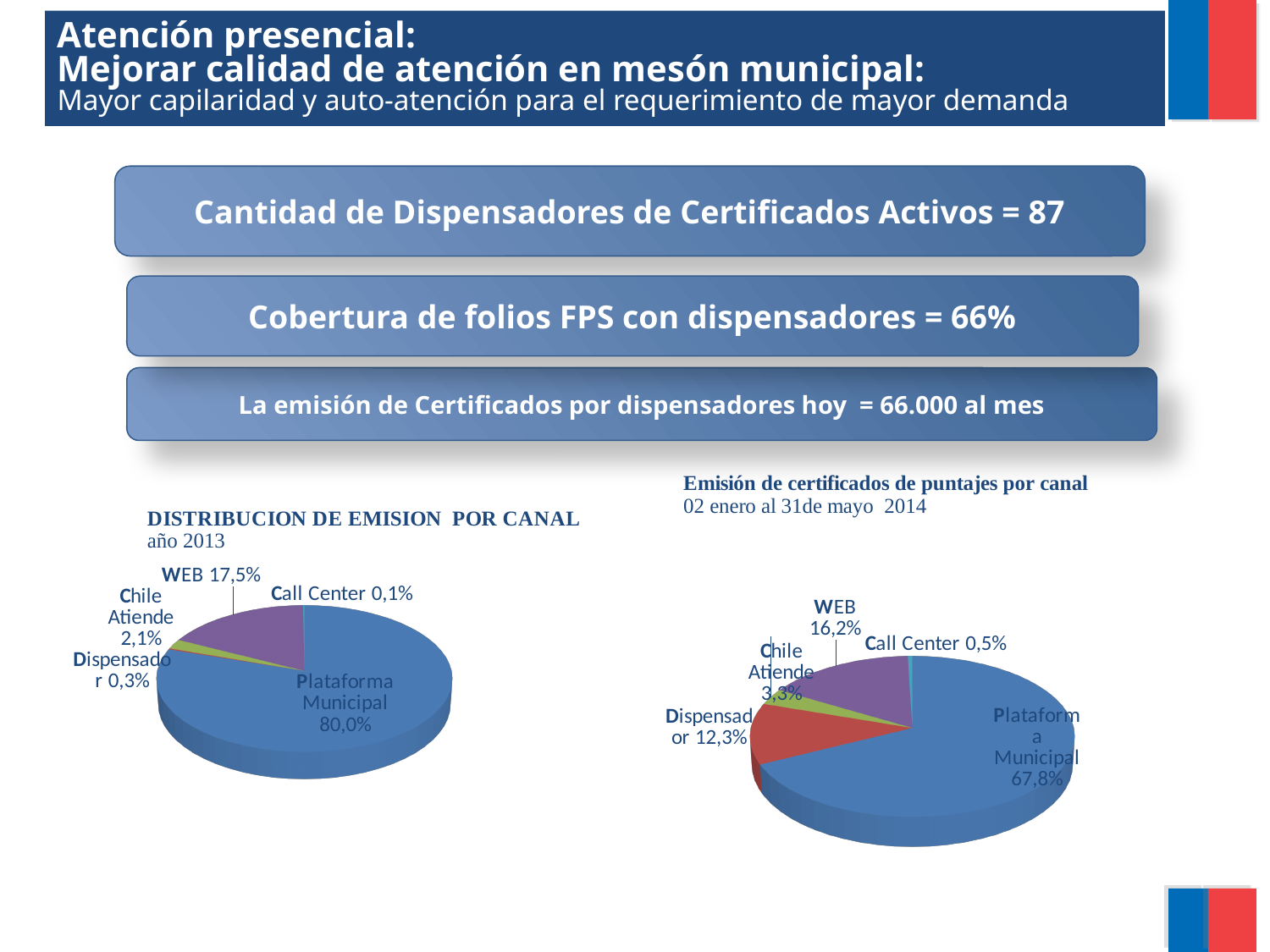
In the 2014 chart 'Emisión de certificados de puntajes por canal', what share does Dispensador have? 12,3% In the 2013 chart 'DISTRIBUCION DE EMISION POR CANAL', what share does Plataforma Municipal have? 80,0% In the 2013 chart 'DISTRIBUCION DE EMISION POR CANAL', what share does WEB have? 17,5% What type of chart is the 2013 chart 'DISTRIBUCION DE EMISION POR CANAL'? Pie chart In the 2014 chart 'Emisión de certificados de puntajes por canal', which is larger: WEB or Dispensador? WEB In the 2013 chart 'DISTRIBUCION DE EMISION POR CANAL', how many channels are shown? 5 In the 2014 chart 'Emisión de certificados de puntajes por canal', what share does Plataforma Municipal have? 67,8% In the 2014 chart 'Emisión de certificados de puntajes por canal', which channel has the largest share? Plataforma Municipal In the 2013 chart 'DISTRIBUCION DE EMISION POR CANAL', what share does Call Center have? 0,1% In the 2013 chart 'DISTRIBUCION DE EMISION POR CANAL', which channel has the smallest share? Call Center In the 2014 chart 'Emisión de certificados de puntajes por canal', what share does Chile Atiende have? 3,3% What is the difference between the Plataforma Municipal share in the 2013 chart and in the 2014 chart? 12,2 percentage points